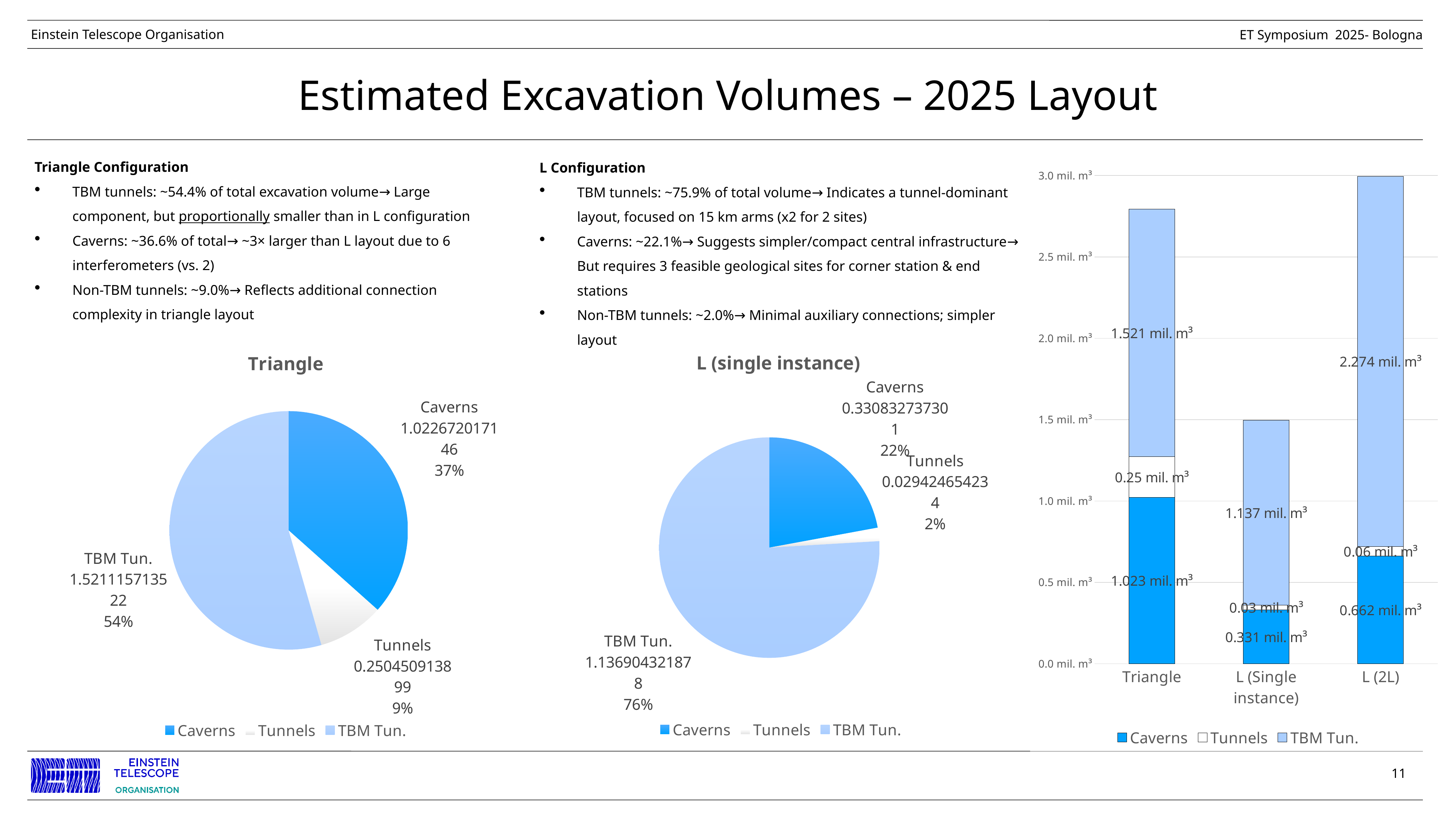
In the stacked bar chart on the right, which category has the tallest bar overall? L (2L) In the stacked bar chart on the right, what is the Caverns value for L (2L)? 0.662 mil. m³ In the Triangle pie chart, which slice is the smallest? Tunnels In the stacked bar chart on the right, what is the total of the L (Single instance) bar? 1.498 mil. m³ In the stacked bar chart on the right, what is the difference between the TBM Tun. values for L (2L) and Triangle? 0.753 mil. m³ In the stacked bar chart on the right, how many categories are shown on the x axis? 3 In the Triangle pie chart, what share of the pie is TBM Tun.? 54% In the L (single instance) pie chart, which slice is the largest? TBM Tun. In the L (single instance) pie chart, what share of the pie is Tunnels? 2% In the Triangle pie chart, what share of the pie is Caverns? 37% In the stacked bar chart on the right, what is the TBM Tun. value for Triangle? 1.521 mil. m³ How many series does the legend of the stacked bar chart on the right list? 3